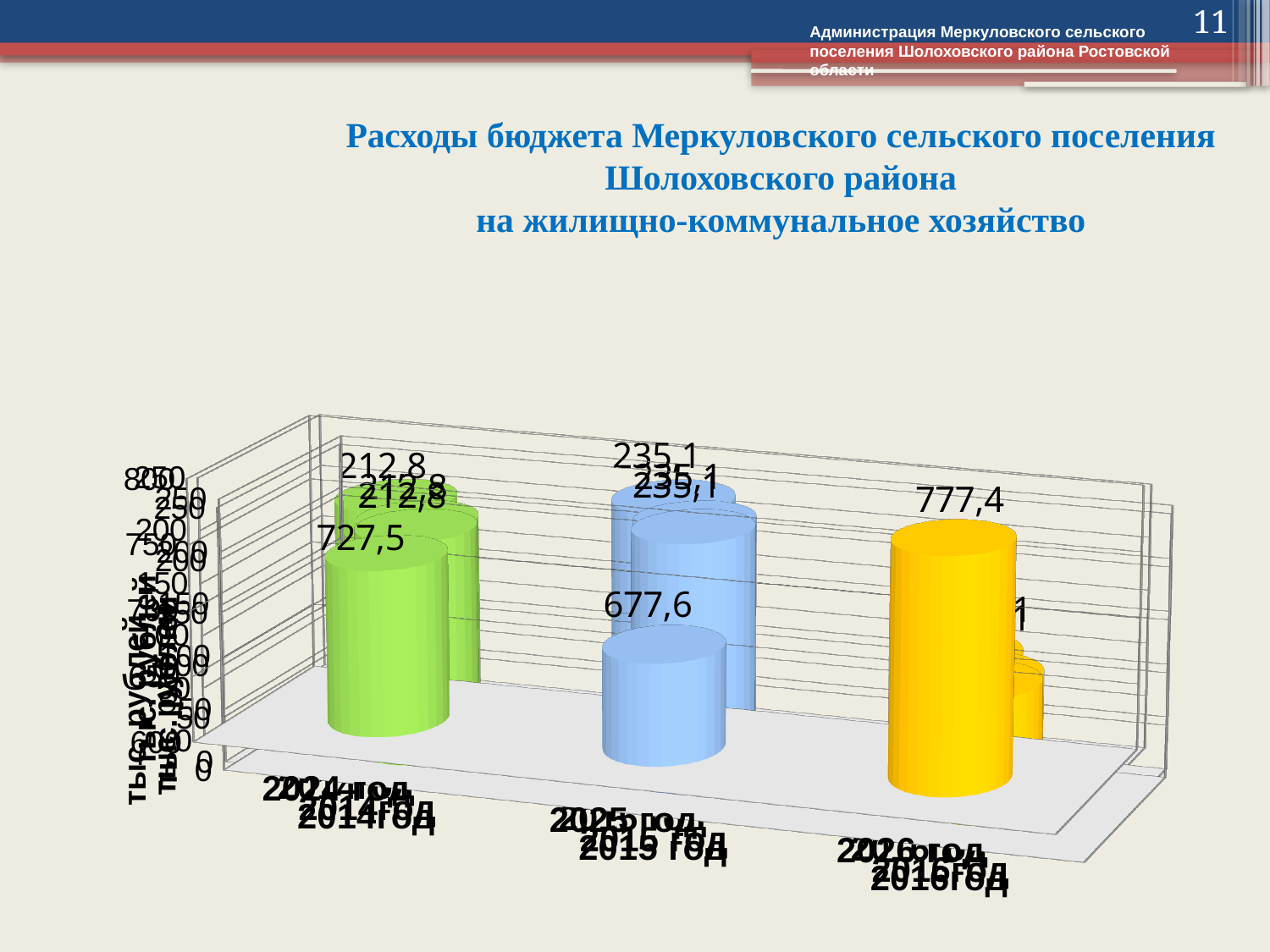
What kind of chart is shown on the slide? bar chart What value is labelled on the large yellow cylinder at the front of the chart? 777,4 What is the title of the chart on the slide? Расходы бюджета Меркуловского сельского поселения Шолоховского района на жилищно-коммунальное хозяйство What is the difference between the labelled values of the yellow front cylinder (777,4) and the blue front cylinder (677,6)? 99,8 Which colour of the three large front cylinders has the lowest labelled value? blue What value is labelled on the smaller blue cylinder behind the front row? 235,1 What value is labelled on the large green cylinder at the front of the chart? 727,5 How many large cylinders are in the front row of the chart? 3 What value is labelled on the large blue cylinder at the front of the chart? 677,6 Which colour of the three large front cylinders has the highest labelled value? yellow What is the difference between the labelled values of the green front cylinder (727,5) and the blue front cylinder (677,6)? 49,9 Which is larger, the labelled value of the green front cylinder or the blue front cylinder? green front cylinder